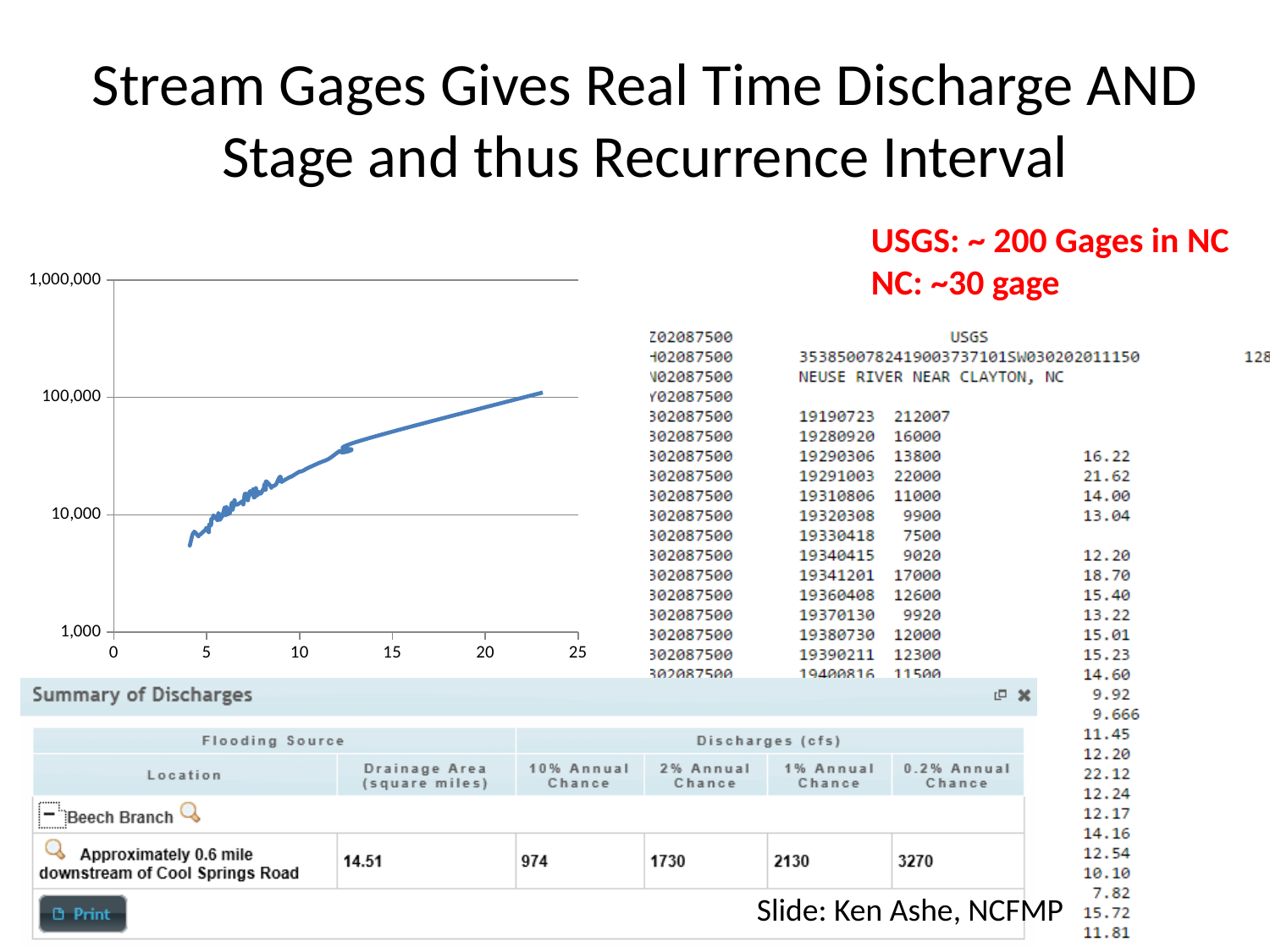
In the chart on the left, which has the larger value: the point at x = 20 or the point at x = 5? x = 20 In the chart on the left, is the value at x = 15 greater or less than 100,000? less How many lines are plotted in the chart on the left? 1 In the chart on the left, do the plotted values rise or fall as the x-axis value increases? rise What is the highest tick label on the y-axis of the chart on the left? 1,000,000 In the chart on the left, is the value at x = 20 greater or less than 100,000? less In the chart on the left, is the value at x = 20 greater or less than 10,000? greater What kind of chart is shown on the left of the slide? line chart What is the highest tick label on the x-axis of the chart on the left? 25